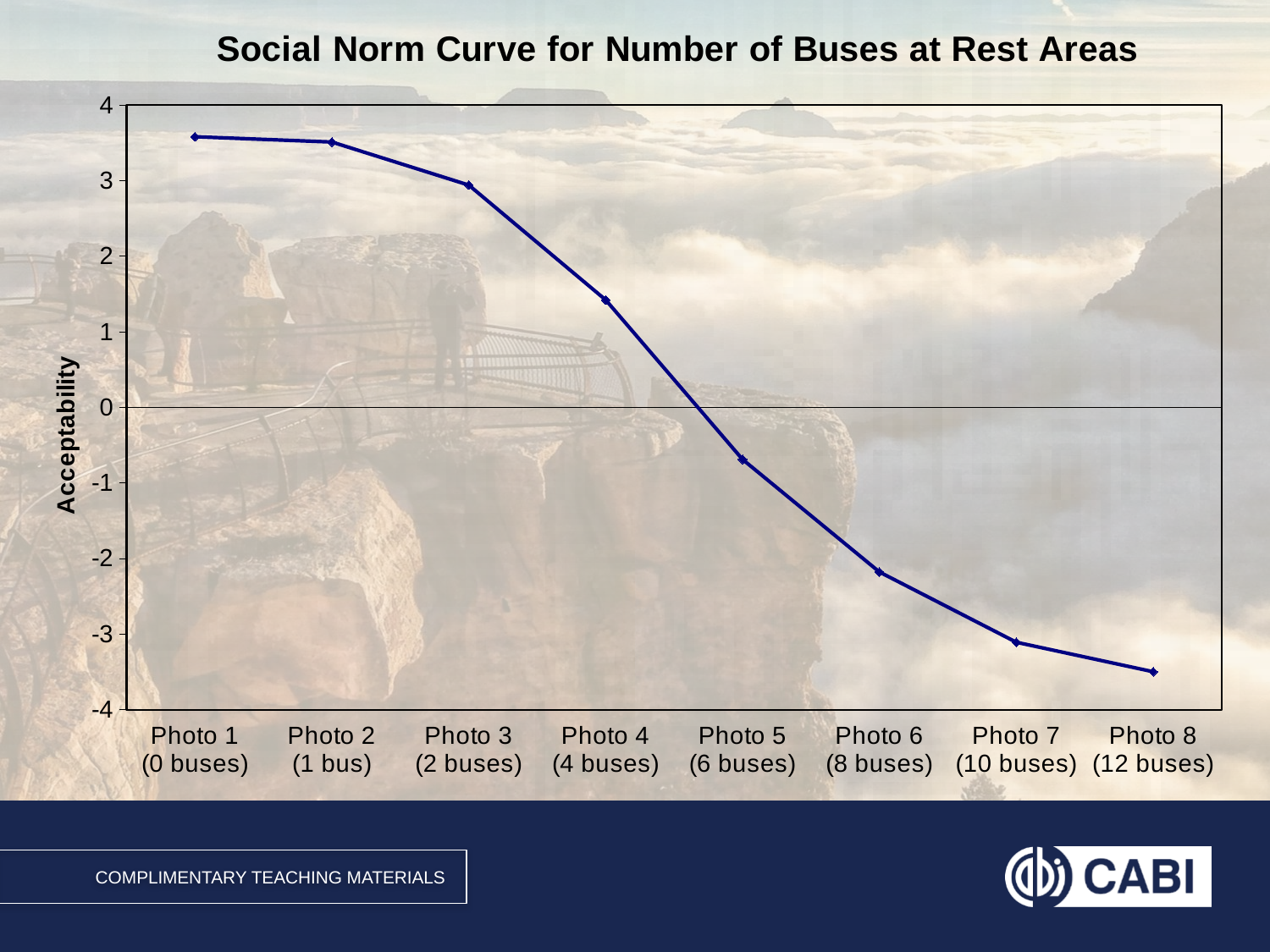
Is the acceptability value for Photo 5 (6 buses) greater or less than 0? less How many photos (data points) are plotted on the chart? 8 Which photo has the lowest acceptability value? Photo 8 (12 buses) What kind of chart is shown on the slide? line chart Is the acceptability value for Photo 4 (4 buses) greater or less than 1? greater Which has the higher acceptability value, Photo 4 (4 buses) or Photo 5 (6 buses)? Photo 4 (4 buses) Which has the higher acceptability value, Photo 3 (2 buses) or Photo 6 (8 buses)? Photo 3 (2 buses) Is the acceptability value for Photo 7 (10 buses) greater or less than -2? less What is the title of the chart? Social Norm Curve for Number of Buses at Rest Areas What is the label on the vertical axis of the chart? Acceptability Do the acceptability values rise or fall as the number of buses increases from Photo 1 to Photo 8? fall